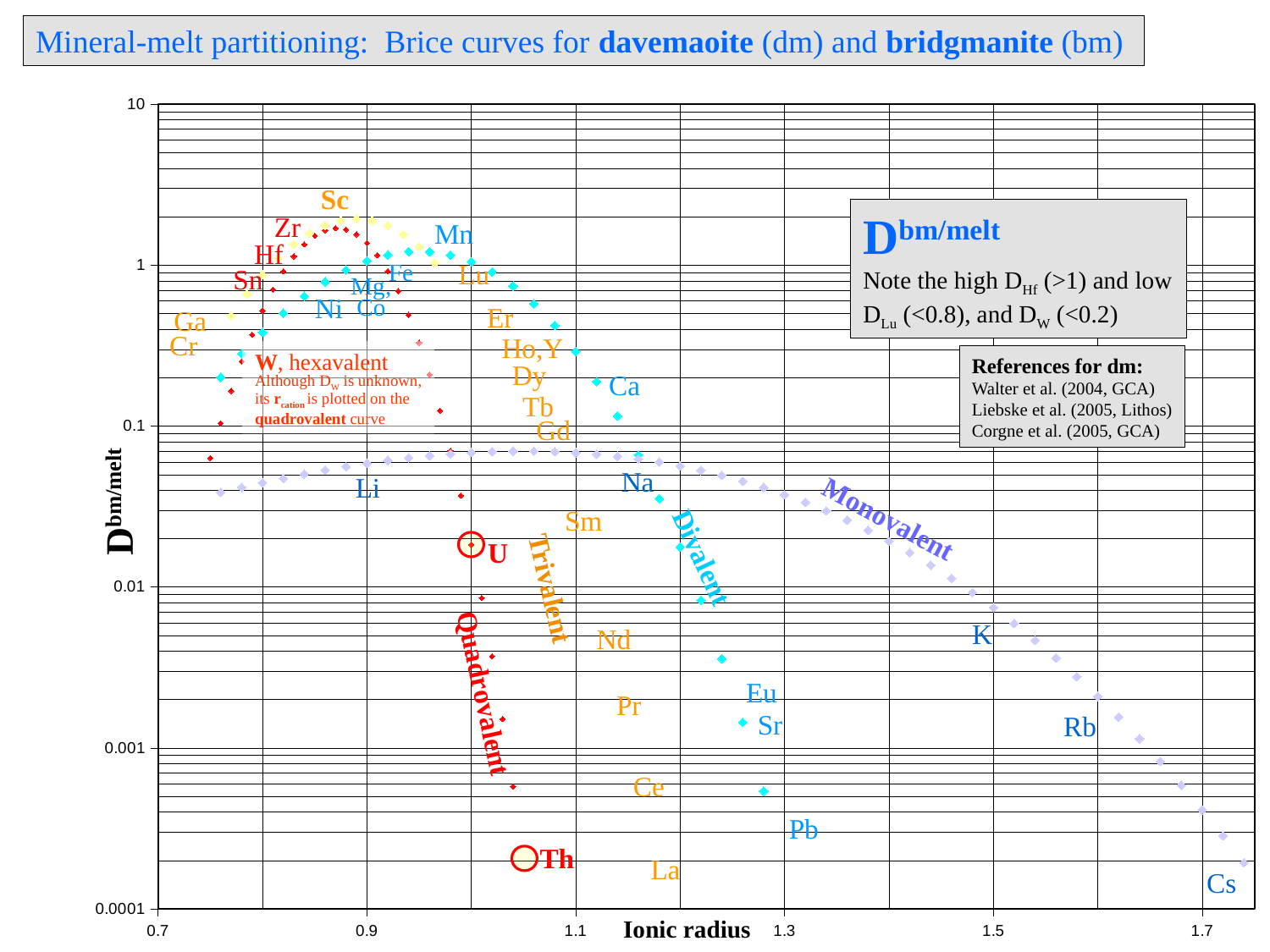
What kind of chart is shown on the slide? scatter chart Is the value for K greater or less than 0.01? less Is the value for Sc greater or less than 1? greater Along the monovalent curve, do the values rise or fall as ionic radius increases from Na to Cs? fall Is the value for Hf greater or less than 1? greater What is the label of the y axis? D bm/melt What is the label of the x axis? Ionic radius Which has the larger value, Hf or Cs? Hf